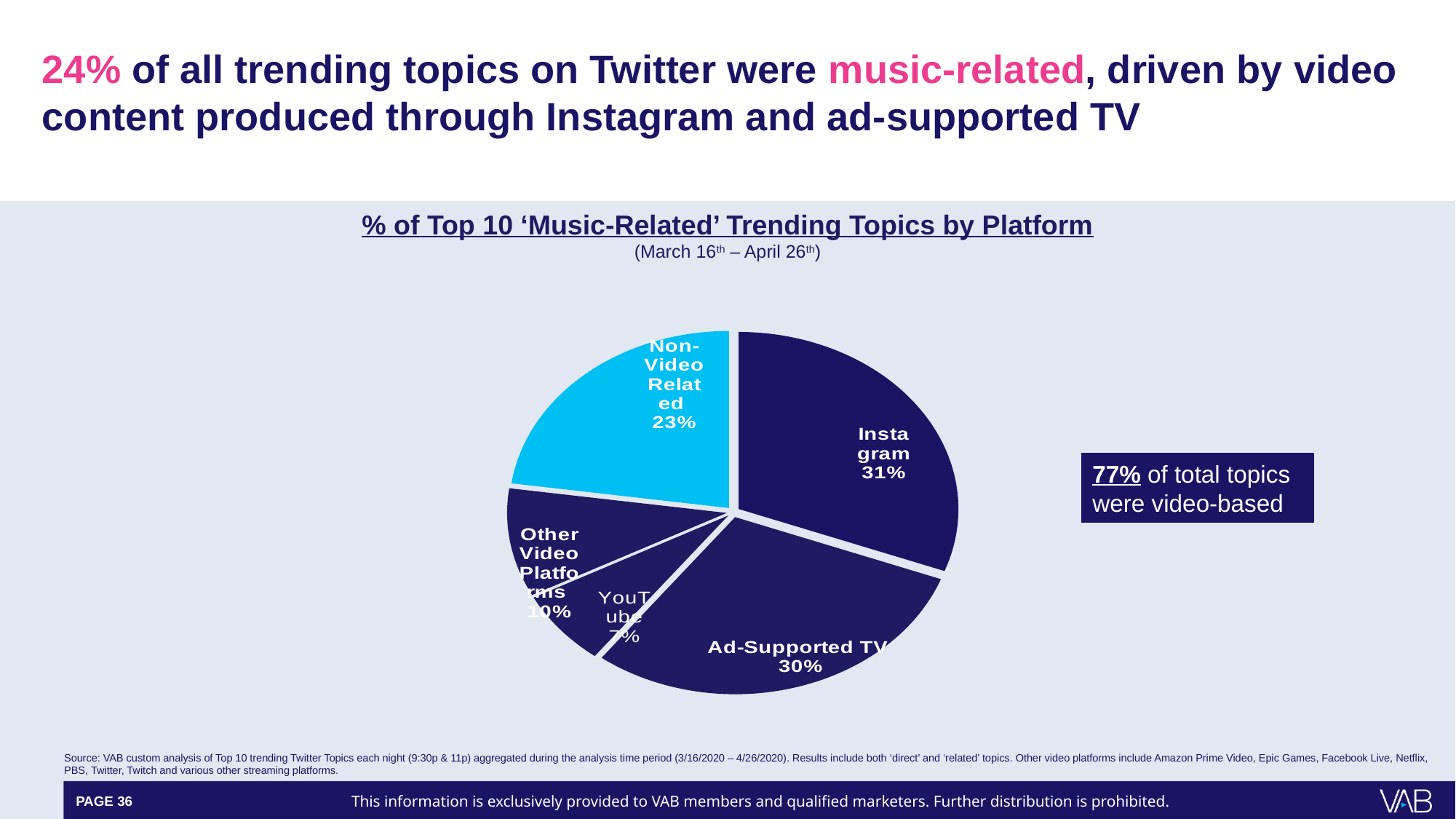
What percentage of the pie is Non-Video Related? 23% What percentage of the pie does Ad-Supported TV account for? 30% Which slice of the pie is the smallest? YouTube What type of chart is shown on the slide? pie chart What percentage of the pie do Other Video Platforms account for? 10% What is the difference in percentage points between Non-Video Related and Other Video Platforms? 13 How many slices does the pie chart have? 5 What is the title of the chart? % of Top 10 'Music-Related' Trending Topics by Platform What percentage of the pie does YouTube account for? 7% Which platform has the largest share of the pie? Instagram What percentage of the pie does Instagram account for? 31% Which slice is larger, Other Video Platforms or YouTube? Other Video Platforms